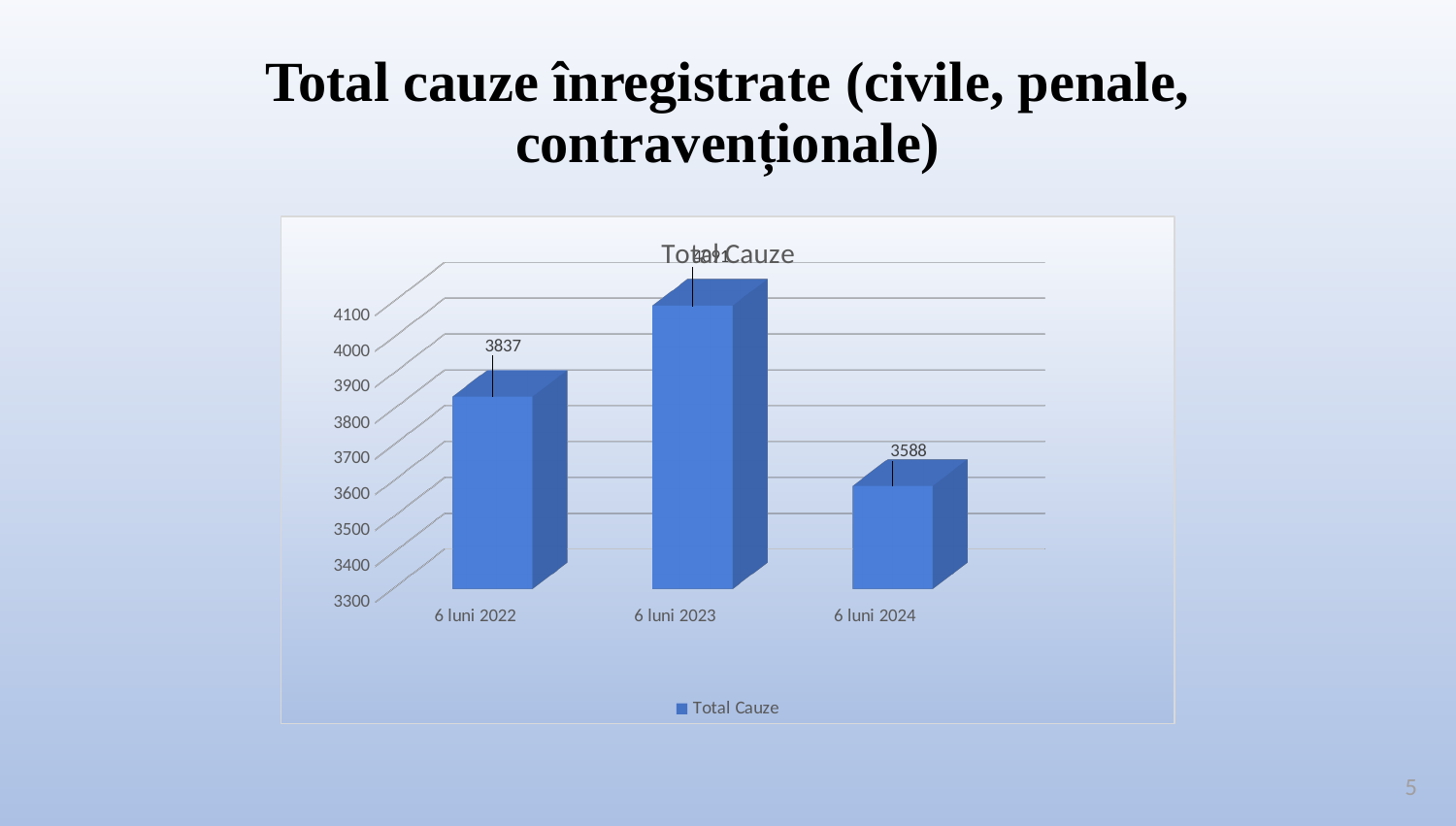
How many series does the legend list? 1 Which category has the highest value? 6 luni 2023 Is the value for 6 luni 2024 greater or less than 3700? less Which category has the lowest value? 6 luni 2024 Is the value for 6 luni 2023 greater or less than 4000? greater Which is larger, the value for 6 luni 2022 or the value for 6 luni 2024? 6 luni 2022 How many categories are shown on the x axis? 3 What is the difference between the values for 6 luni 2022 and 6 luni 2024? 249 What is the value for 6 luni 2024? 3588 What is the name of the series shown in the legend? Total Cauze What is the value for 6 luni 2022? 3837 What kind of chart is shown? bar chart